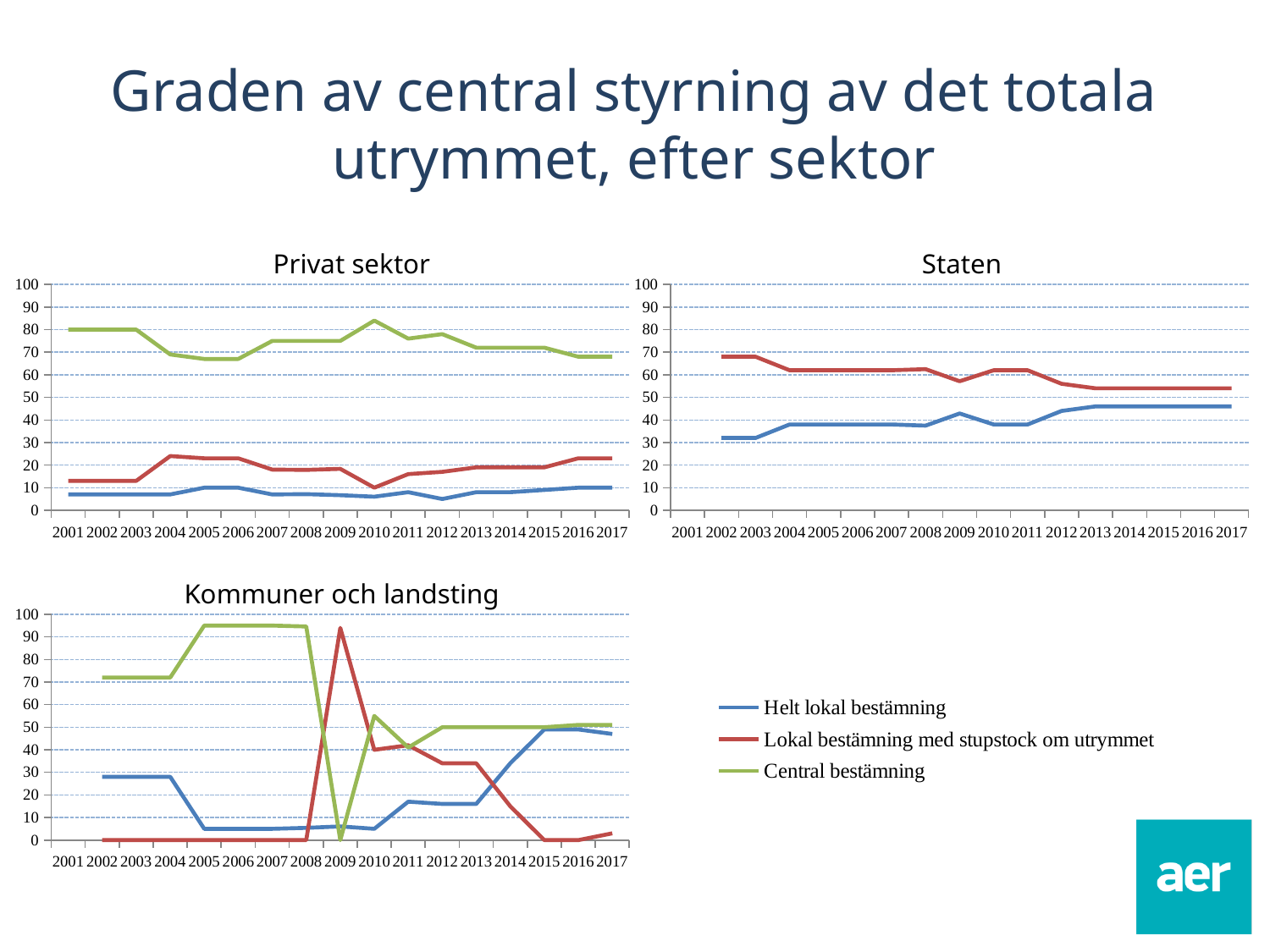
How many series does the legend list? 3 What colour is the line for Central bestämning in the legend? green In the 'Staten' chart, which series has the larger value in 2017: Helt lokal bestämning or Lokal bestämning med stupstock om utrymmet? Lokal bestämning med stupstock om utrymmet What kind of chart is the 'Privat sektor' chart? line chart In the 'Kommuner och landsting' chart, is the value for Central bestämning in 2005 greater or less than 90? greater In the 'Kommuner och landsting' chart, is the value for Central bestämning in 2009 greater or less than 10? less In the 'Staten' chart, how many years are shown on the x axis? 17 In the 'Privat sektor' chart, is the value for Central bestämning in 2010 greater or less than 80? greater In the 'Privat sektor' chart, which series has the highest values across all years? Central bestämning In the 'Staten' chart, does the value for Lokal bestämning med stupstock om utrymmet rise or fall from 2001 to 2017? fall